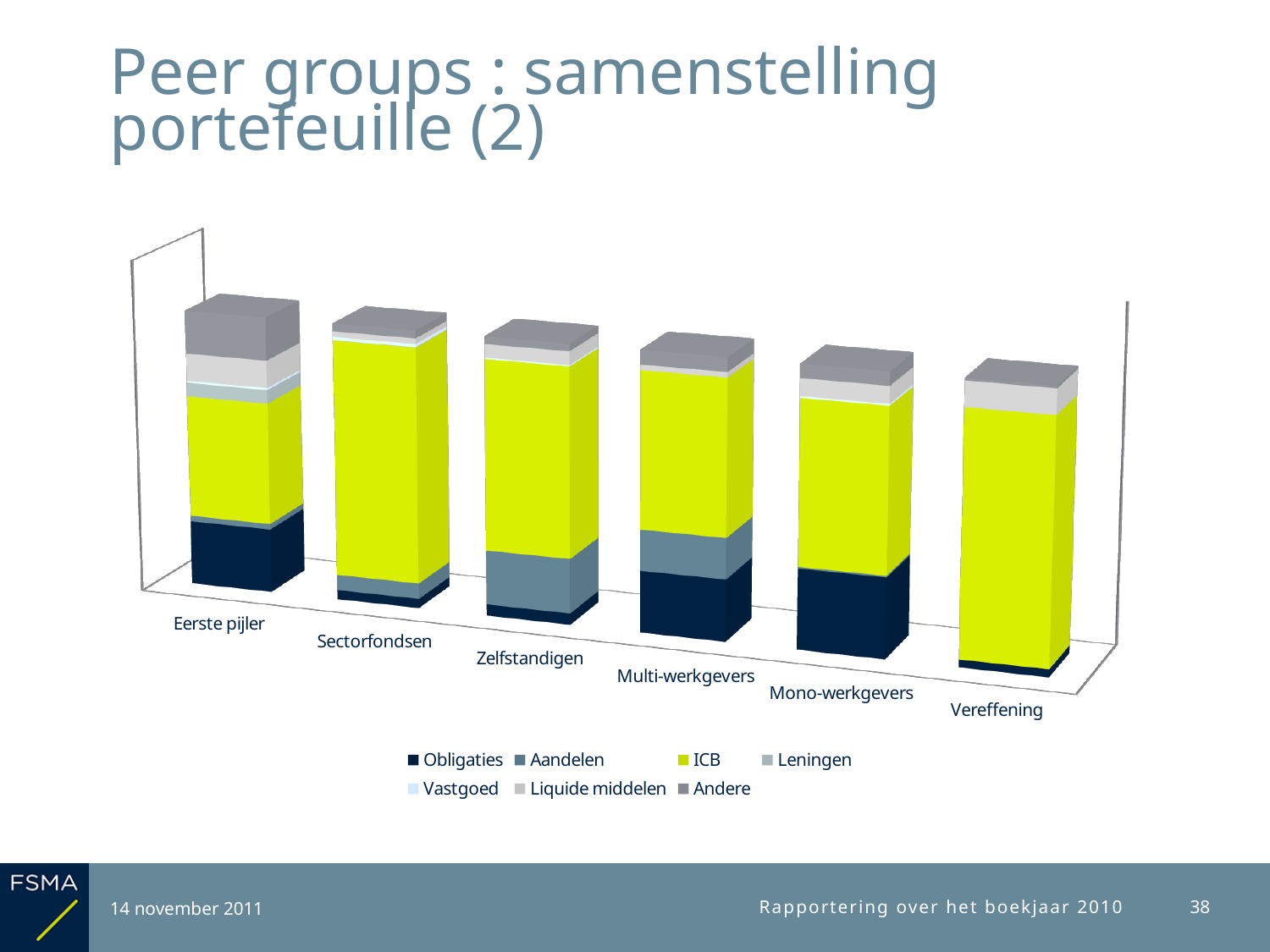
Which series is shown in bright yellow-green in the chart? ICB Is the ICB segment larger for Vereffening or for Eerste pijler? Vereffening What kind of chart is shown on the slide? Stacked bar chart Which peer group has the largest Obligaties segment in the chart? Mono-werkgevers Is the Obligaties segment larger for Mono-werkgevers or for Vereffening? Mono-werkgevers What is the title of the slide containing the chart? Peer groups : samenstelling portefeuille (2) Is the Aandelen segment larger for Zelfstandigen or for Sectorfondsen? Zelfstandigen How many series does the chart's legend list? 7 Which peer group has the largest Aandelen segment in the chart? Zelfstandigen Which peer group has the largest Andere segment in the chart? Eerste pijler How many categories (peer groups) are shown on the x axis of the chart? 6